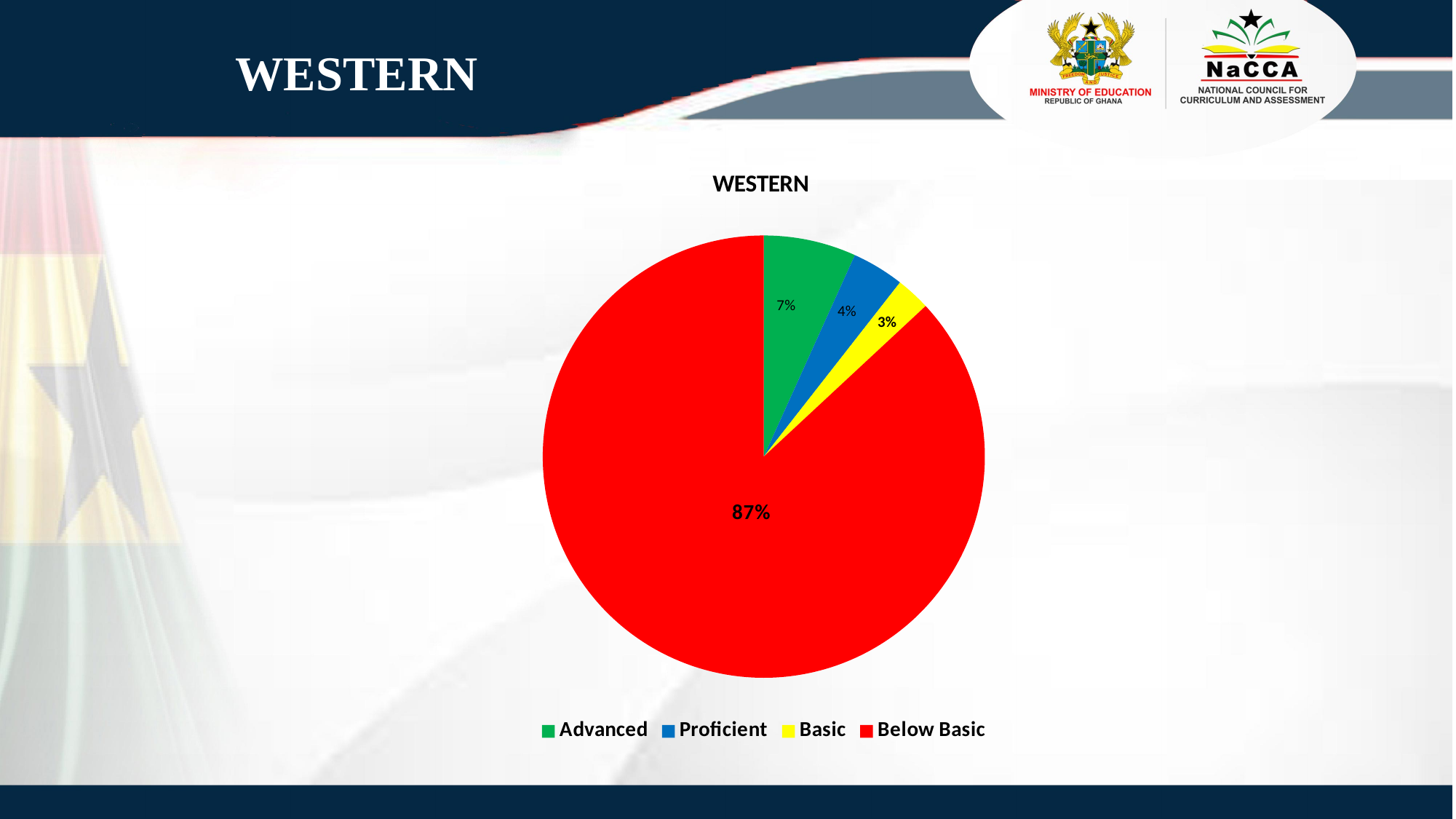
Which category has the largest share of the pie? Below Basic What is the chart's title? WESTERN What percentage of the pie is Basic? 3% Which category has the smallest share of the pie? Basic What type of chart is shown on the slide? pie chart How many categories does the legend list? 4 What is the difference between the Below Basic share and the Advanced share? 80% Which is larger, the Advanced share or the Proficient share? Advanced What percentage of the pie is Below Basic? 87% What percentage of the pie is Advanced? 7% What colour represents Below Basic in the chart? red What percentage of the pie is Proficient? 4%